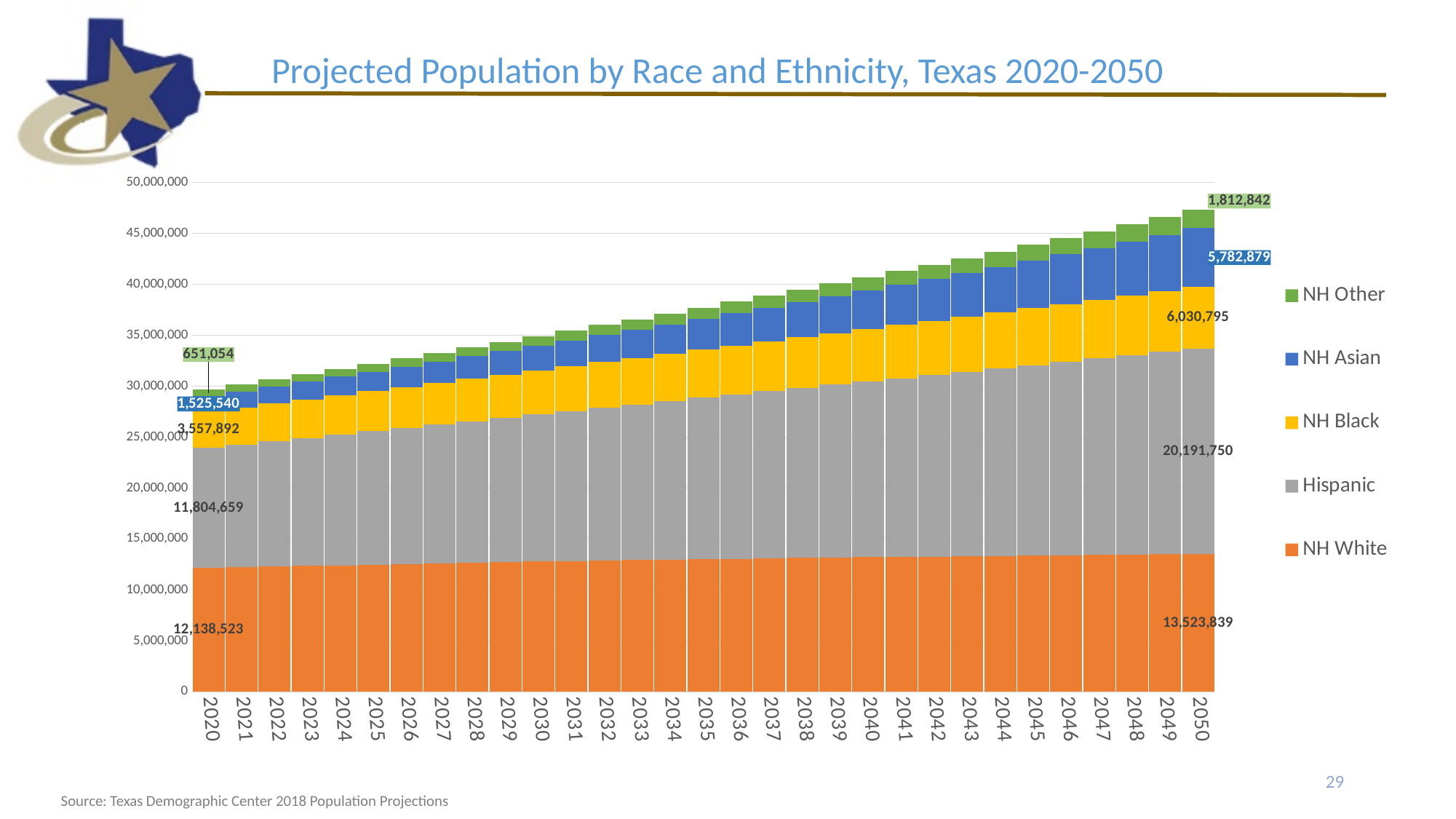
What is the projected NH Other population in 2020? 651,054 Is the total projected population for 2035 greater or less than 35,000,000? greater In 2020, which is larger: the NH White population or the Hispanic population? NH White What is the projected Hispanic population for Texas in 2050? 20,191,750 What is the total projected population of Texas in 2050 according to the stacked bar? 47,342,105 Which race/ethnicity group has the largest projected population in 2050? Hispanic What is the projected NH White population for Texas in 2020? 12,138,523 Does the total projected population rise or fall from 2020 to 2050? rise What is the projected NH Asian population in 2050? 5,782,879 By how much is the projected Hispanic population in 2050 larger than in 2020? 8,387,091 Which race/ethnicity group has the smallest projected population in 2020? NH Other How many series does the legend list? 5